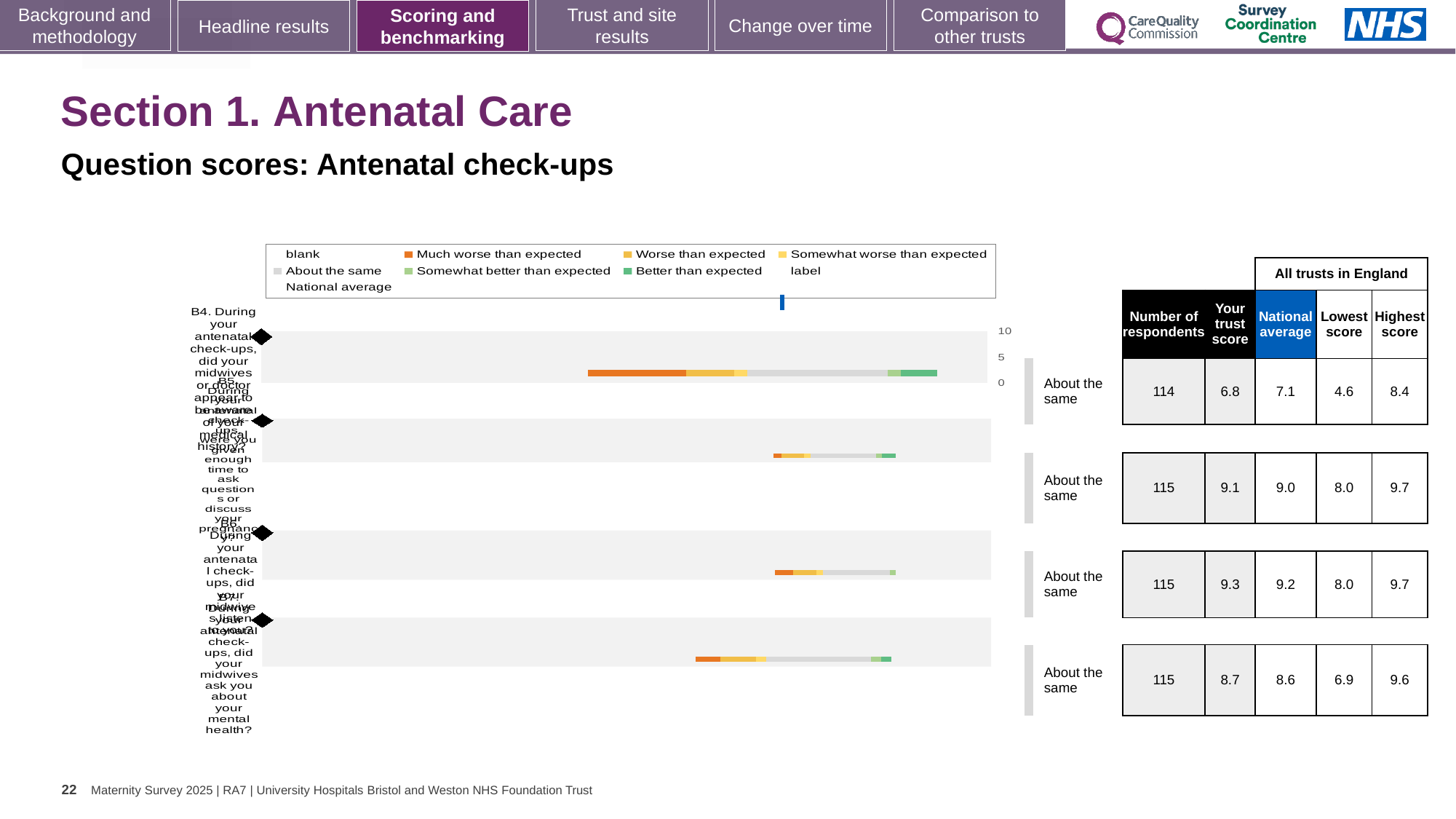
For question B4, which is larger: the trust score or the national average? National average What benchmark category is shown next to each of the four question bars? About the same Which question (B4, B5, B6 or B7) has the highest trust score in the table? B6 In the table beside the chart, what is the national average for question B5? 9.0 In the table beside the chart, what is the trust score for question B4 (midwives or doctor appear to be aware of your medical history)? 6.8 How many question bars (B4 to B7) are plotted in the chart? 4 In the table beside the chart, what is the highest score across all trusts in England for question B7? 9.6 What is the difference between the highest score and the lowest score for question B6 in the table? 1.7 In the table beside the chart, what is the number of respondents for question B4? 114 Which question (B4, B5, B6 or B7) has the lowest trust score in the table? B4 Which legend entry is shown in dark orange? Much worse than expected What kind of chart is shown on the slide? bar chart